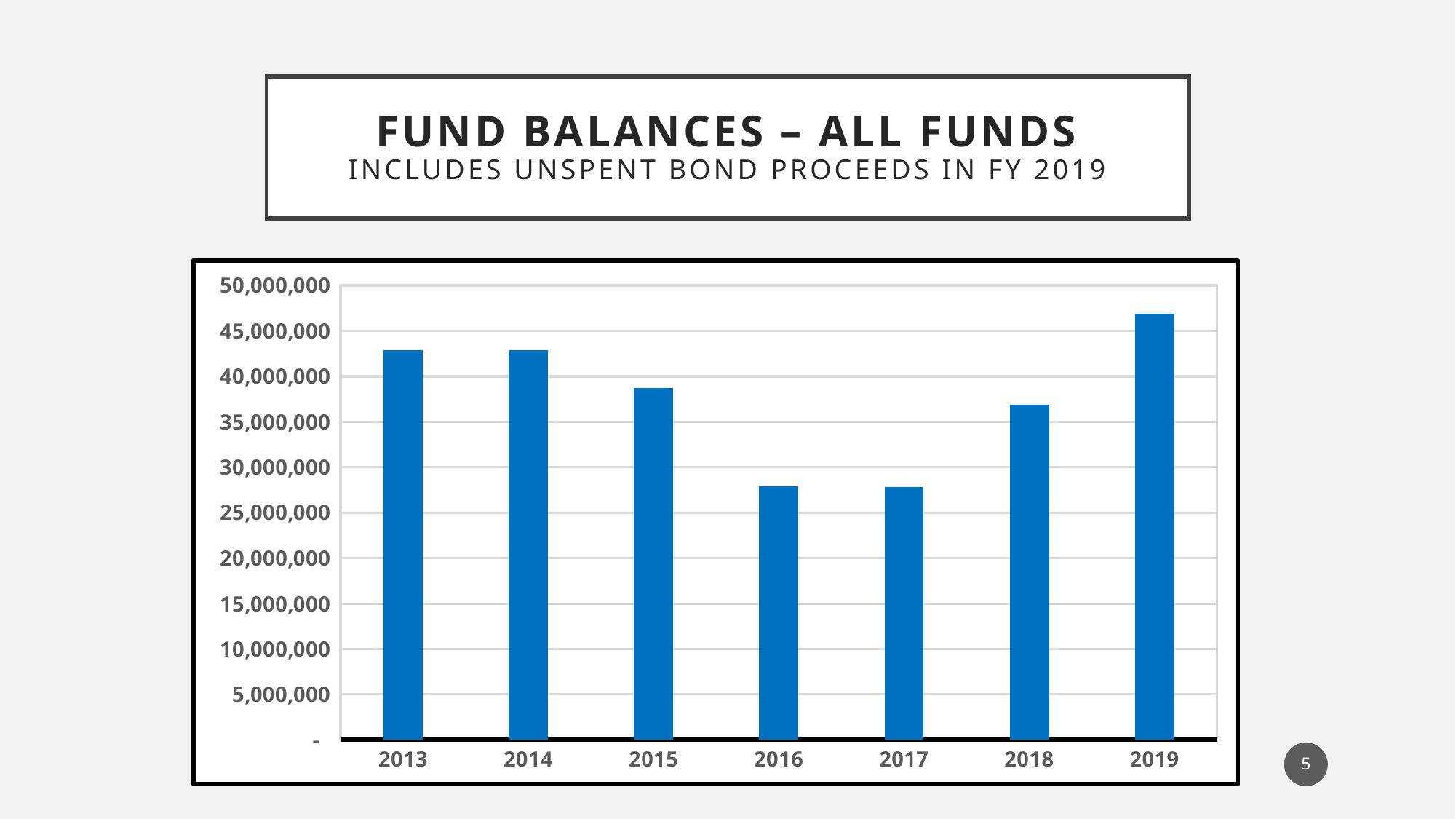
How many years are shown on the x axis of the chart? 7 Is the fund balance for 2016 greater or less than 30,000,000? less Which is larger, the fund balance for 2015 or for 2016? 2015 Is the fund balance for 2018 greater or less than 35,000,000? greater Which year has the highest fund balance in the chart? 2019 Is the fund balance for 2015 greater or less than 40,000,000? less What kind of chart is shown on the slide? bar chart Do the fund balances rise or fall from 2017 to 2019? rise Which is larger, the fund balance for 2018 or for 2019? 2019